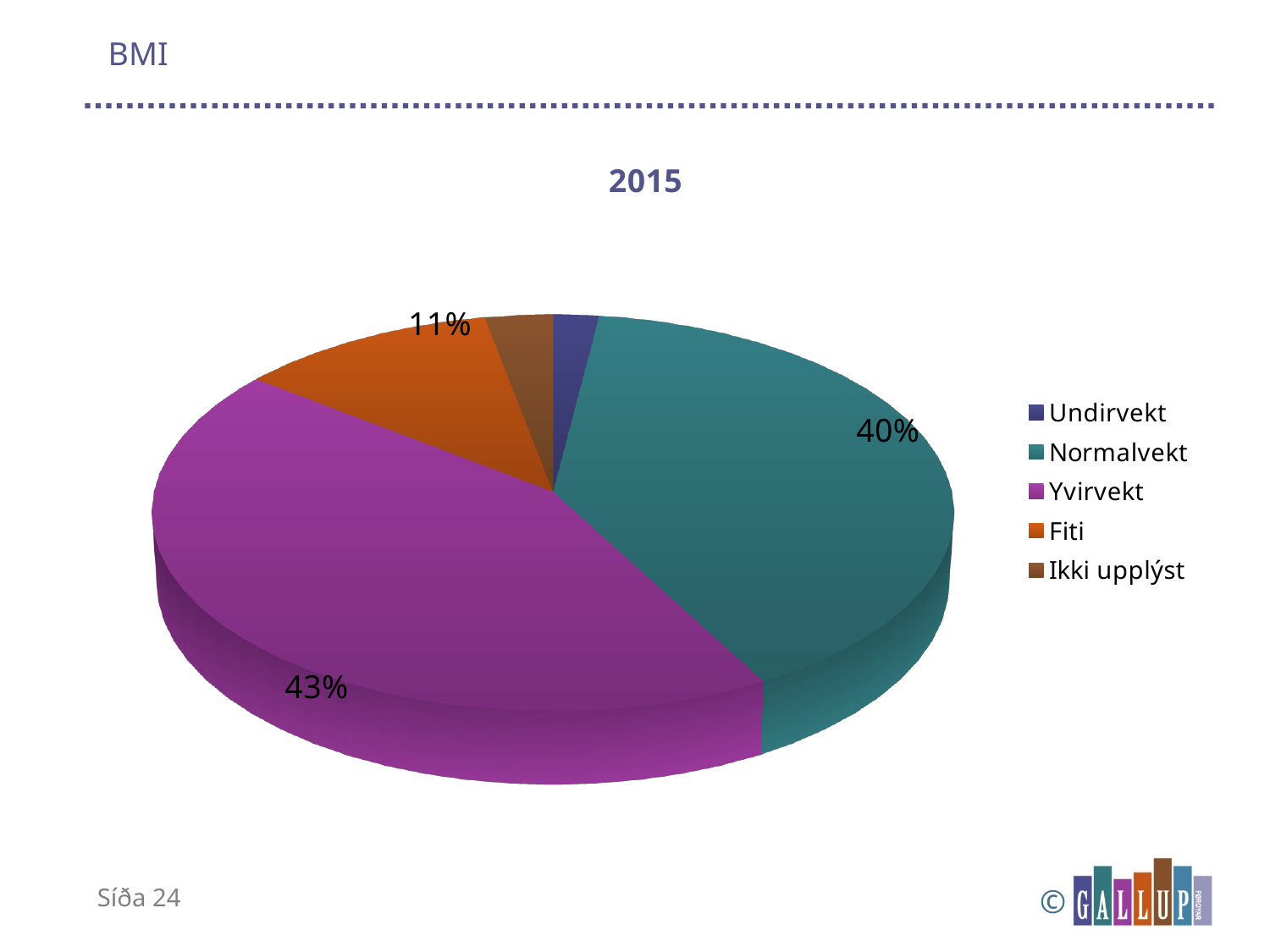
What percentage of the pie does Normalvekt represent? 40% What percentage of the pie does Fiti represent? 11% What is the title of the chart? 2015 What is the difference in percentage points between Yvirvekt and Normalvekt? 3 percentage points How many categories are shown in the pie chart? 5 Which is larger, the share for Yvirvekt or the share for Normalvekt? Yvirvekt What is the difference in percentage points between Yvirvekt and Fiti? 32 percentage points What kind of chart is shown on the slide? Pie chart Which category has the largest share of the pie? Yvirvekt What colour is the Yvirvekt slice? Purple What percentage of the pie does Yvirvekt represent? 43% Which is larger, the share for Normalvekt or the share for Fiti? Normalvekt